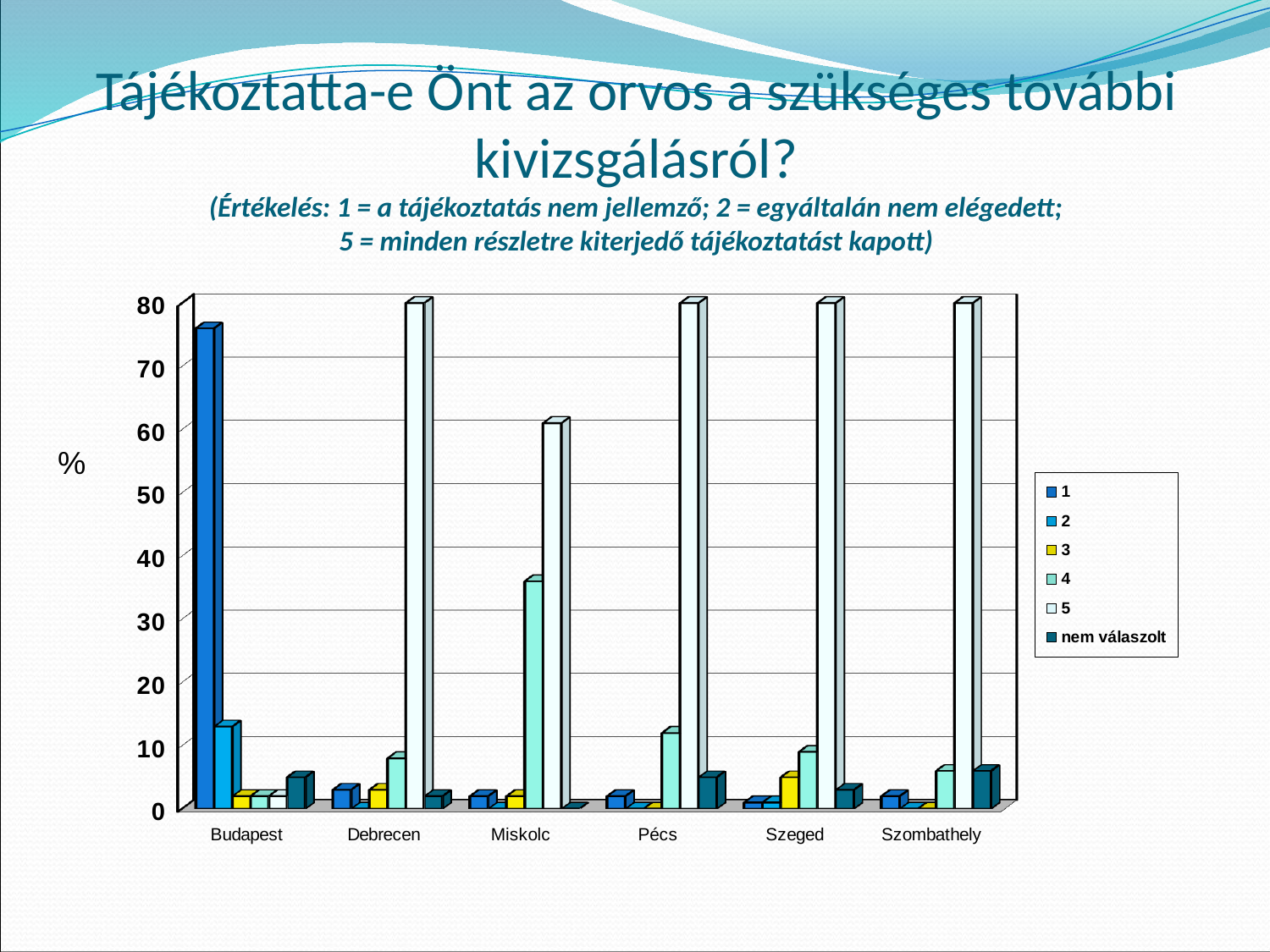
How many series does the chart legend list? 6 What kind of chart is shown on the slide? bar chart What is the label of the last entry in the chart legend? nem válaszolt Is the value for series 5 in Miskolc greater or less than 70? less Which is larger for Budapest: the value for series 1 or the value for series 2? 1 Is the value for series 4 in Miskolc greater or less than 30? greater Which city has the highest value for series 1? Budapest Which series has the highest value for Budapest? 1 Is the value for series 1 in Budapest greater or less than 70? greater How many cities (categories) are shown on the x axis of the chart? 6 Which city has the highest value for series 4? Miskolc Which is larger for Miskolc: the value for series 4 or the value for series 5? 5